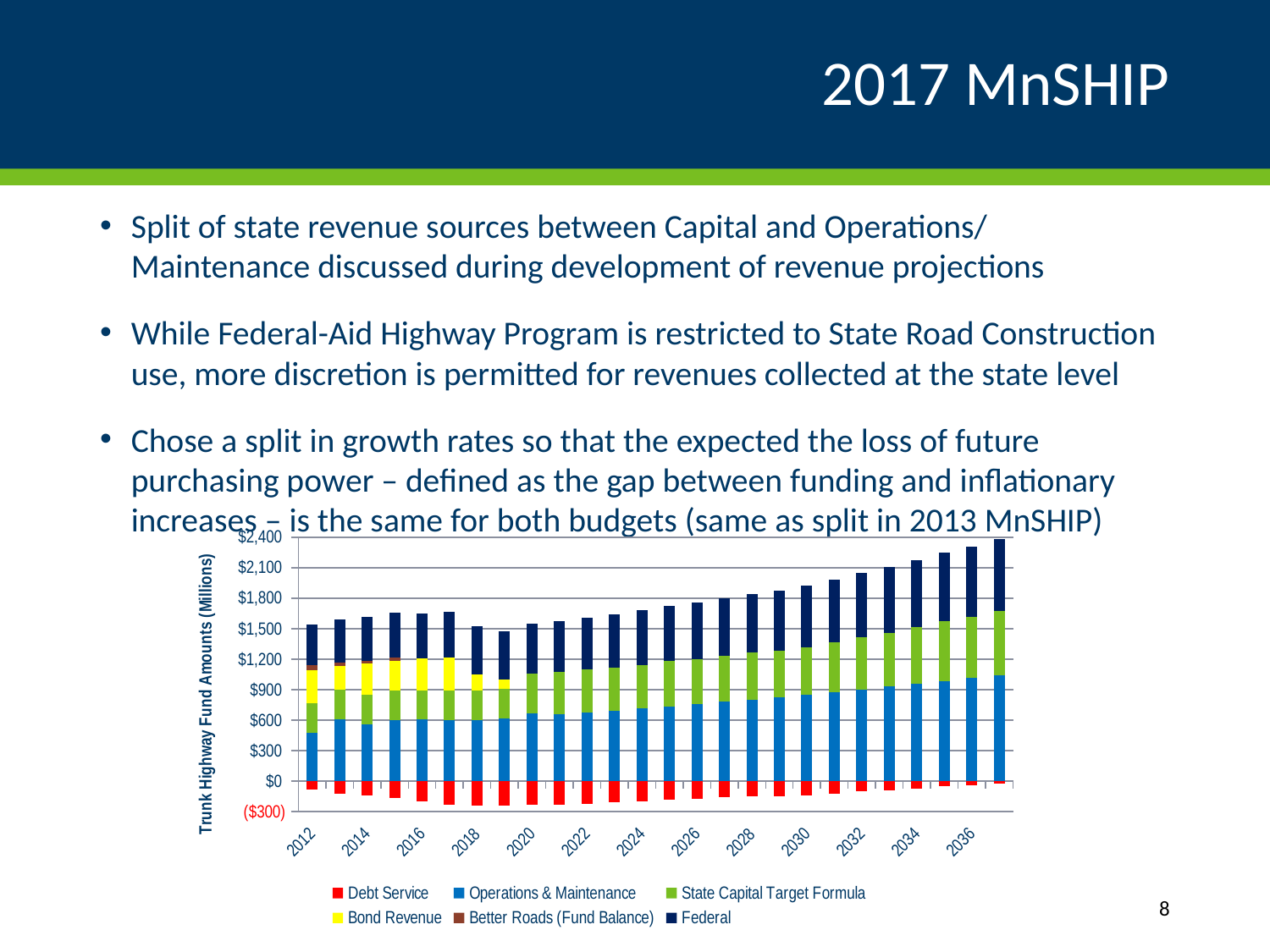
Is the Operations & Maintenance value for 2012 greater or less than $600? less How many series does the chart legend list? 6 Is the total stacked height of the 2030 bar greater or less than $1,800? greater Do the Operations & Maintenance values generally rise or fall from 2012 to 2036? rise Is the total stacked height of the 2036 bar greater or less than $2,100? greater Which year has the tallest stacked bar in the chart? 2037 What is the label on the vertical axis of the chart? Trunk Highway Fund Amounts (Millions) Is the Operations & Maintenance value larger in 2012 or in 2036? 2036 Which series is shown in yellow in the chart? Bond Revenue What kind of chart is shown on the slide? Stacked bar chart